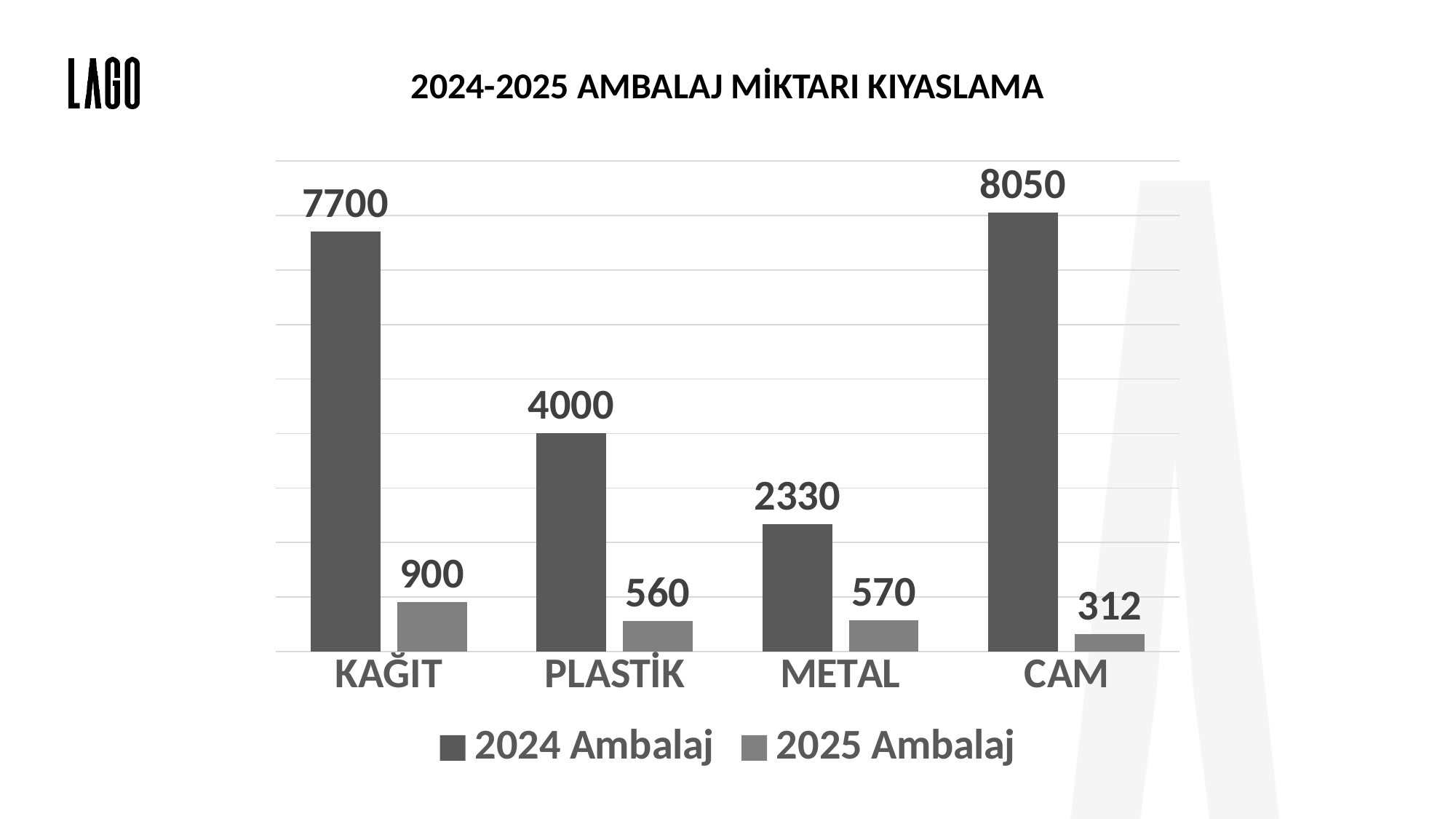
Which category has the highest 2024 Ambalaj value? CAM What is the title of the chart? 2024-2025 AMBALAJ MİKTARI KIYASLAMA What is the 2025 Ambalaj value for CAM? 312 What kind of chart is shown on the slide? Bar chart How many series does the legend list? 2 Which category has the lowest 2025 Ambalaj value? CAM Which is larger: the 2025 Ambalaj value for KAĞIT or for METAL? KAĞIT What is the 2024 Ambalaj value for METAL? 2330 What is the difference between the 2024 Ambalaj and 2025 Ambalaj values for PLASTİK? 3440 How many categories are shown on the x axis? 4 What is the 2024 Ambalaj value for KAĞIT? 7700 What is the difference between the 2024 Ambalaj values for CAM and KAĞIT? 350